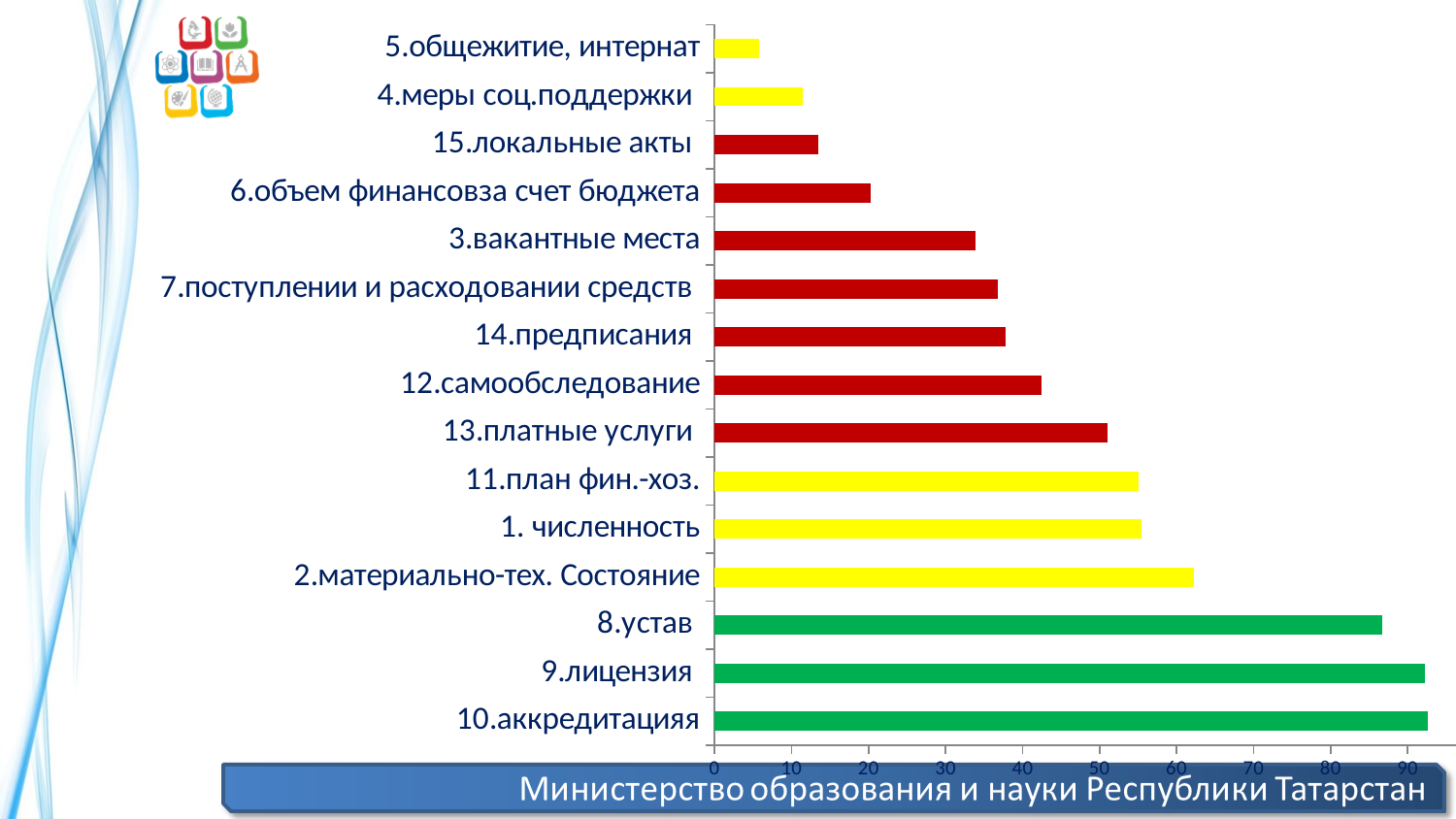
Is the value for 12.самообследование greater or less than 50? less Is the value for 2.материально-тех. Состояние greater or less than 60? greater Which category has the lowest value in the chart? 5.общежитие, интернат What colour is the bar for 9.лицензия? green Is the value for 8.устав greater or less than 80? greater How many categories are plotted in the chart? 15 Which has a larger value, 8.устав or 2.материально-тех. Состояние? 8.устав What kind of chart is shown on the slide? bar chart Which has a larger value, 3.вакантные места or 15.локальные акты? 3.вакантные места